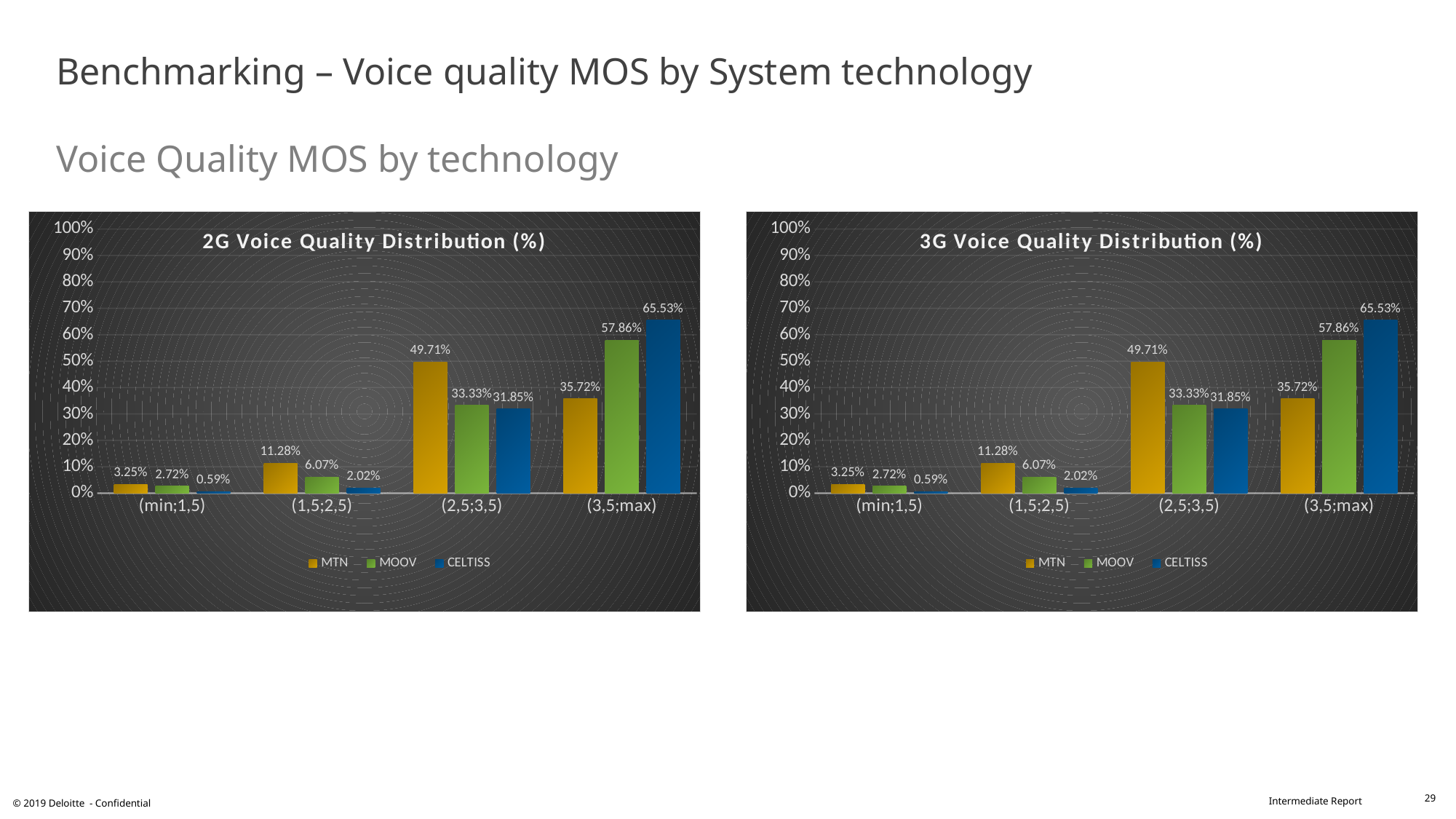
In the 2G Voice Quality Distribution (%) chart, which series has the lowest value in the (min;1,5) category? CELTISS In the 2G Voice Quality Distribution (%) chart, what is the difference between MTN and MOOV in the (2,5;3,5) category? 16.38% In the 2G Voice Quality Distribution (%) chart, what is the value for MTN in the (2,5;3,5) category? 49.71% What kind of chart is the 3G Voice Quality Distribution (%) chart? Bar chart In the 2G Voice Quality Distribution (%) chart, what is the value for MOOV in the (1,5;2,5) category? 6.07% In the 3G Voice Quality Distribution (%) chart, which series has the highest value in the (3,5;max) category? CELTISS In the 3G Voice Quality Distribution (%) chart, what is the value for CELTISS in the (3,5;max) category? 65.53% How many series does the legend of the 2G Voice Quality Distribution (%) chart list? 3 In the 2G Voice Quality Distribution (%) chart, which series is shown in blue? CELTISS In the 3G Voice Quality Distribution (%) chart, which is larger in the (3,5;max) category: MTN or MOOV? MOOV How many categories are shown on the x axis of the 3G Voice Quality Distribution (%) chart? 4 In the 2G Voice Quality Distribution (%) chart, is the value for CELTISS in the (3,5;max) category greater or less than 60%? greater